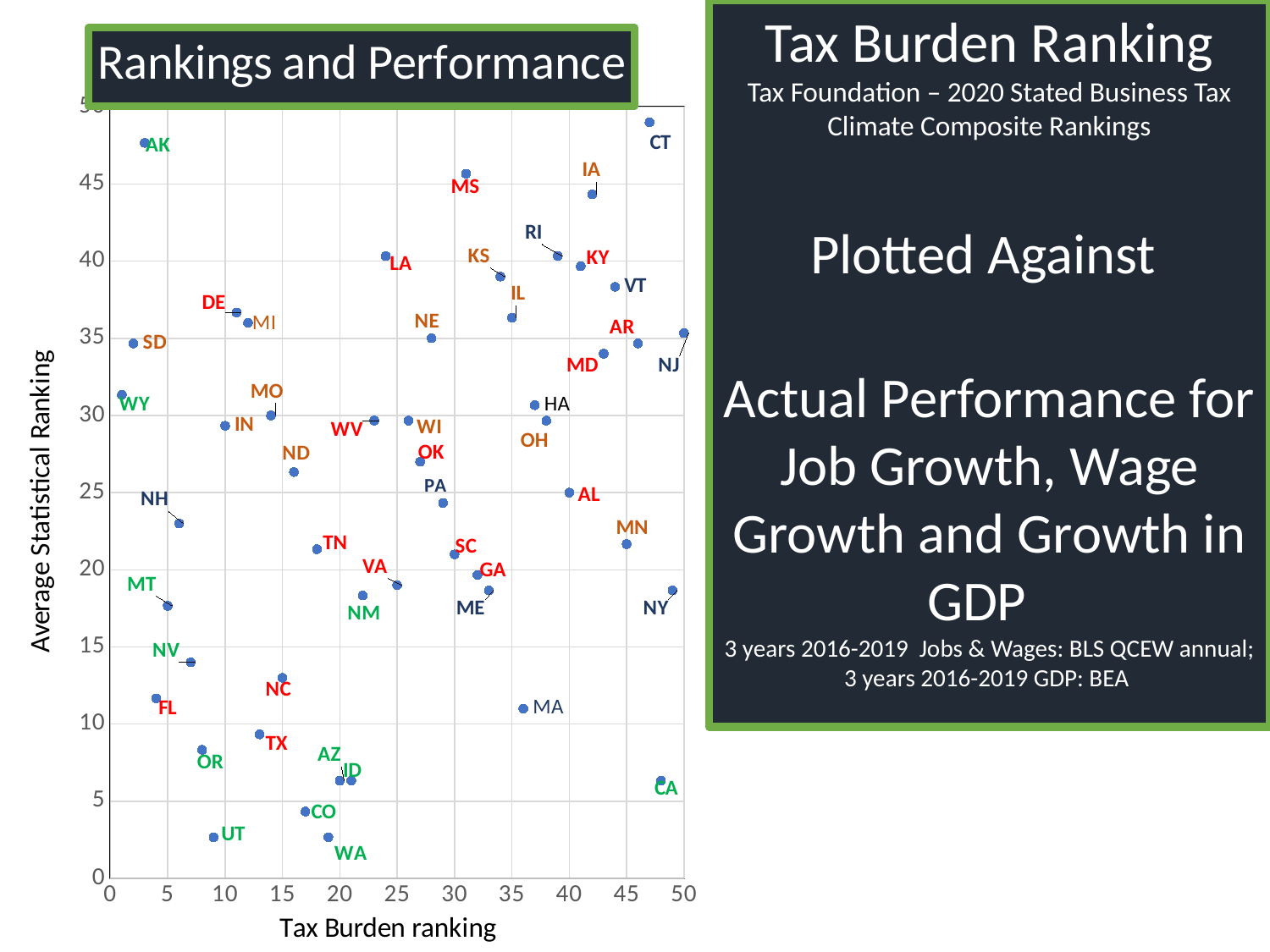
Is the Tax Burden ranking for CA greater or less than 45? greater Which has the larger Tax Burden ranking, WY or NJ? NJ Is the Average Statistical Ranking for AK greater or less than 45? greater Is the Average Statistical Ranking for IA greater or less than 40? greater Which has the higher Average Statistical Ranking, FL or TN? TN What is the title of the y axis of the chart? Average Statistical Ranking What is the title of the x axis of the chart? Tax Burden ranking What kind of chart is shown on the slide? Scatter plot Which state has the highest Average Statistical Ranking on the chart? CT Which has the higher Average Statistical Ranking, MS or LA? MS